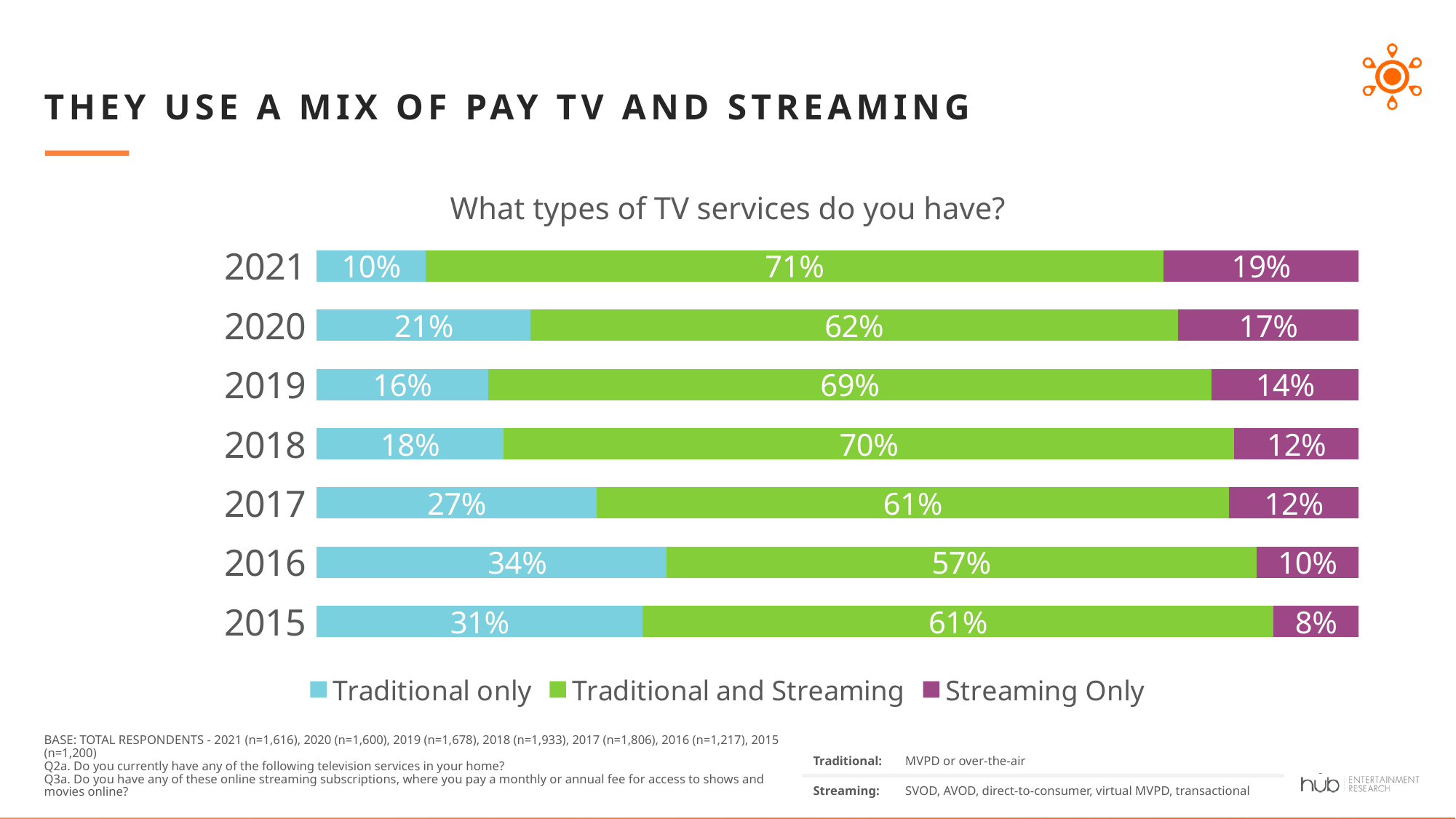
What percentage of respondents had Traditional and Streaming in 2020? 62% What is the title of the chart? What types of TV services do you have? Which is larger: the Traditional only share in 2017 or in 2019? 2017 How many series does the legend list? 3 In which year was the Traditional only share highest? 2016 What is the difference between the Streaming Only share in 2021 and in 2015? 11 percentage points In which year was the Streaming Only share lowest? 2015 What kind of chart is shown on the slide? Stacked bar chart How many years are shown in the chart? 7 Does the Streaming Only share rise or fall from 2015 to 2021? Rise What percentage of respondents had Traditional only TV service in 2021? 10% What percentage of respondents had Streaming Only in 2015? 8%